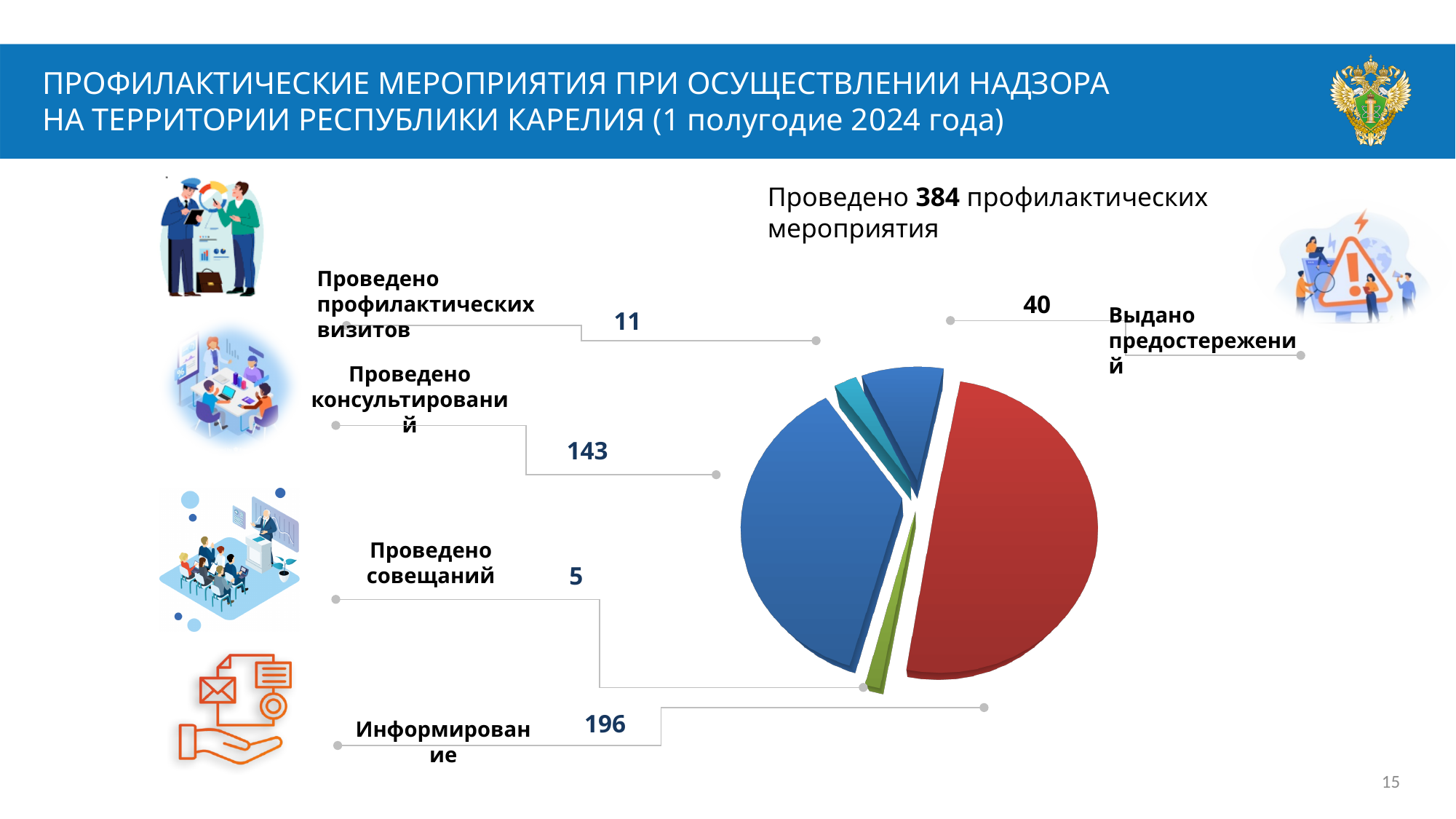
Which is larger: Выдано предостережений or Проведено профилактических визитов? Выдано предостережений What is the value for Проведено консультирований? 143 Which category has the highest value? Информирование What is the value for Проведено совещаний? 5 What colour is the largest slice of the pie chart? red How many categories (slices) does the pie chart have? 5 What is the value for Выдано предостережений? 40 What is the difference between Информирование and Проведено консультирований? 53 Which category has the lowest value? Проведено совещаний What kind of chart is shown on the slide? pie chart What is the value for Информирование? 196 What is the value for Проведено профилактических визитов? 11